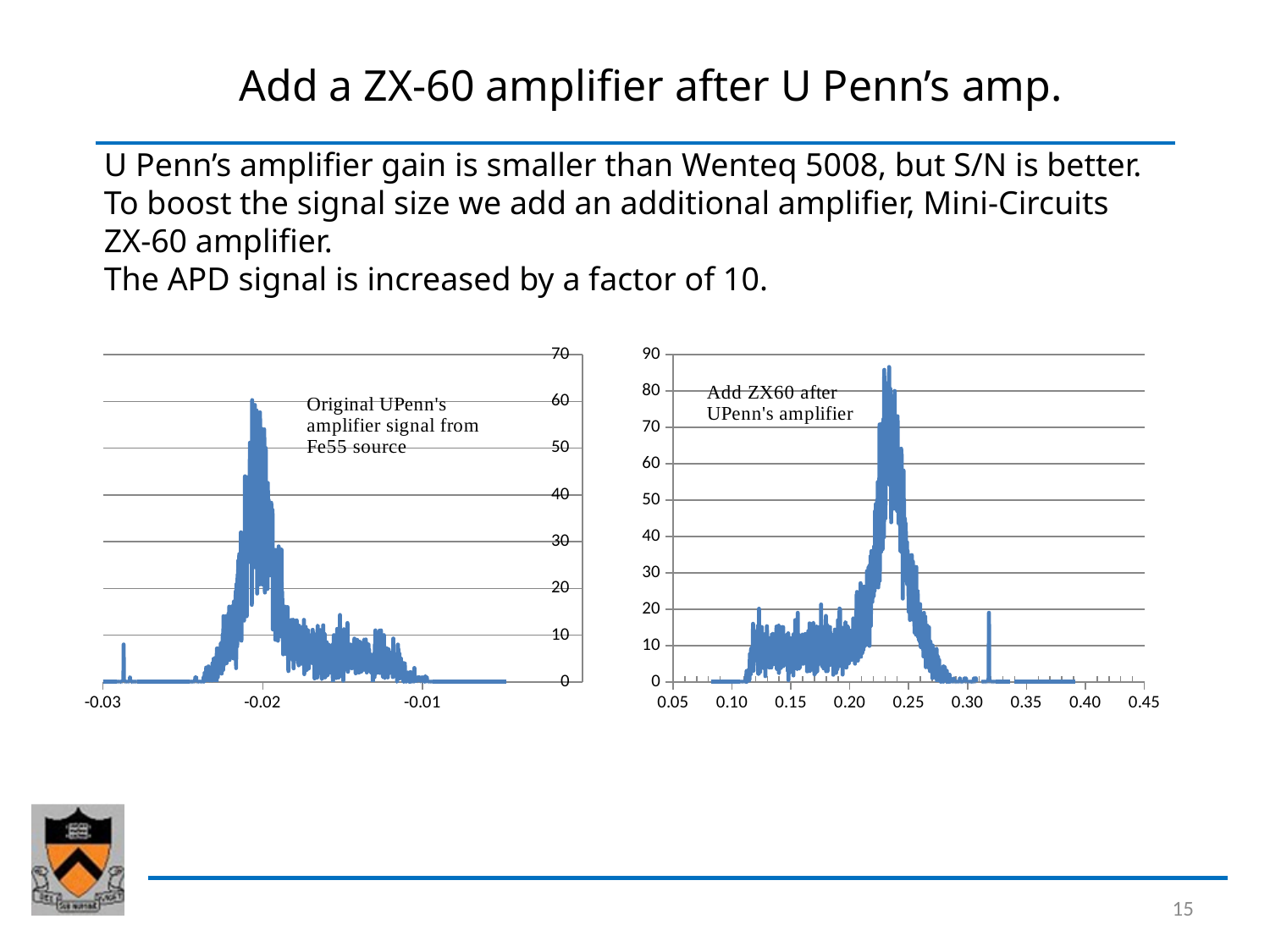
What kind of chart is the left chart, labelled "Original UPenn's amplifier signal from Fe55 source"? line chart What is the text label shown inside the left chart? Original UPenn's amplifier signal from Fe55 source In the right chart (Add ZX60 after UPenn's amplifier), is the isolated spike near x = 0.32 greater or less than 30? less In the left chart (Original UPenn's amplifier signal), is the peak value greater or less than 50? greater Which chart reaches the higher peak value, the left chart (Original UPenn's amplifier signal) or the right chart (Add ZX60 after UPenn's amplifier)? the right chart In the right chart (Add ZX60 after UPenn's amplifier), is the peak value greater or less than 80? greater What is the highest value shown on the y axis of the right chart (Add ZX60 after UPenn's amplifier)? 90 What kind of chart is the right chart, labelled "Add ZX60 after UPenn's amplifier"? line chart